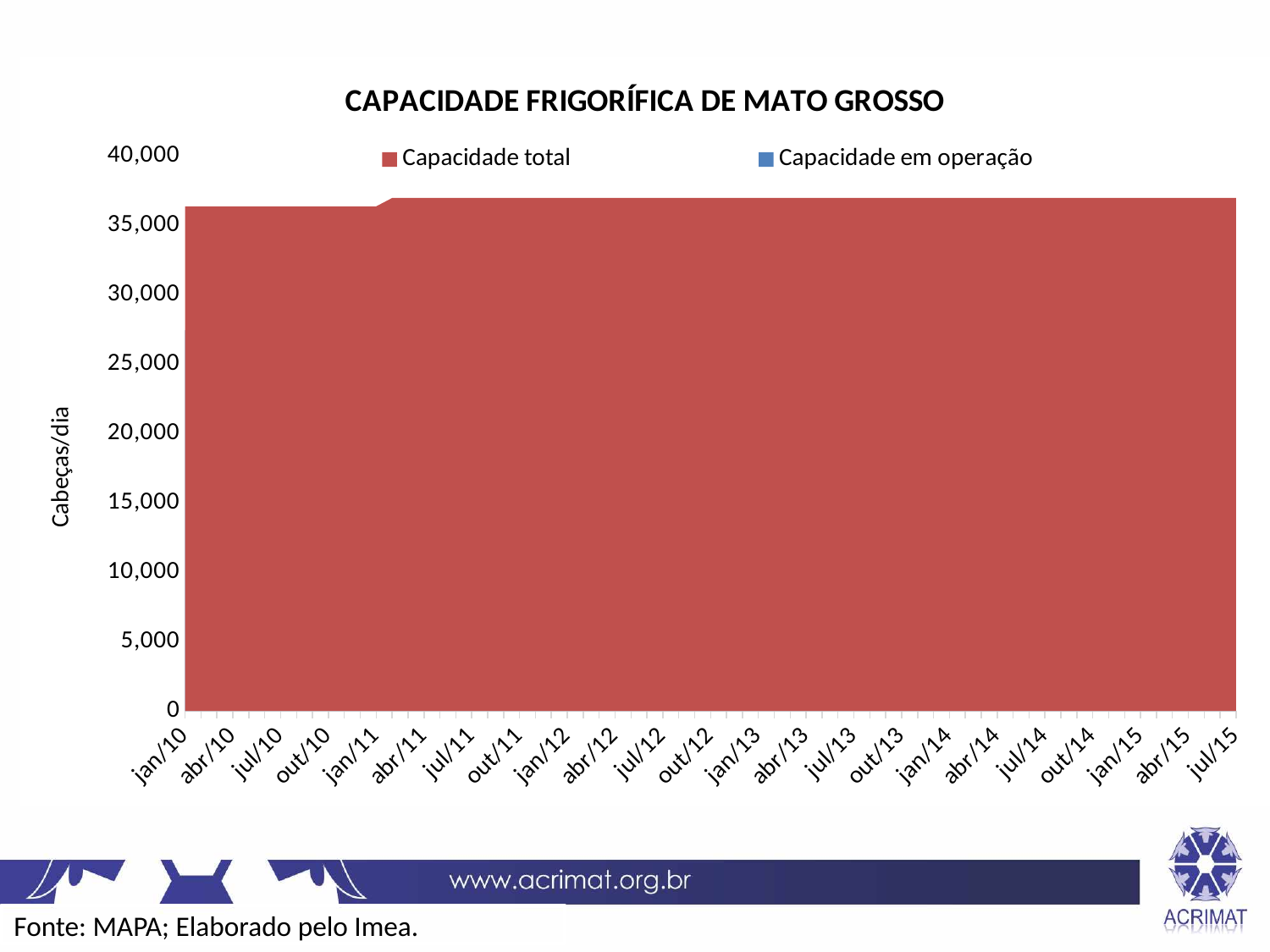
What kind of chart is shown on the slide? Area chart Is the value of Capacidade total at jul/15 greater or less than 35,000? greater Is the value of Capacidade total at jan/10 greater or less than 40,000? less What is the first period shown on the horizontal axis? jan/10 How many period labels are shown on the horizontal axis? 23 How many series does the chart legend list? 2 What is the last period shown on the horizontal axis? jul/15 What is the title of the chart? CAPACIDADE FRIGORÍFICA DE MATO GROSSO Is the value of Capacidade total at jan/13 greater or less than 30,000? greater